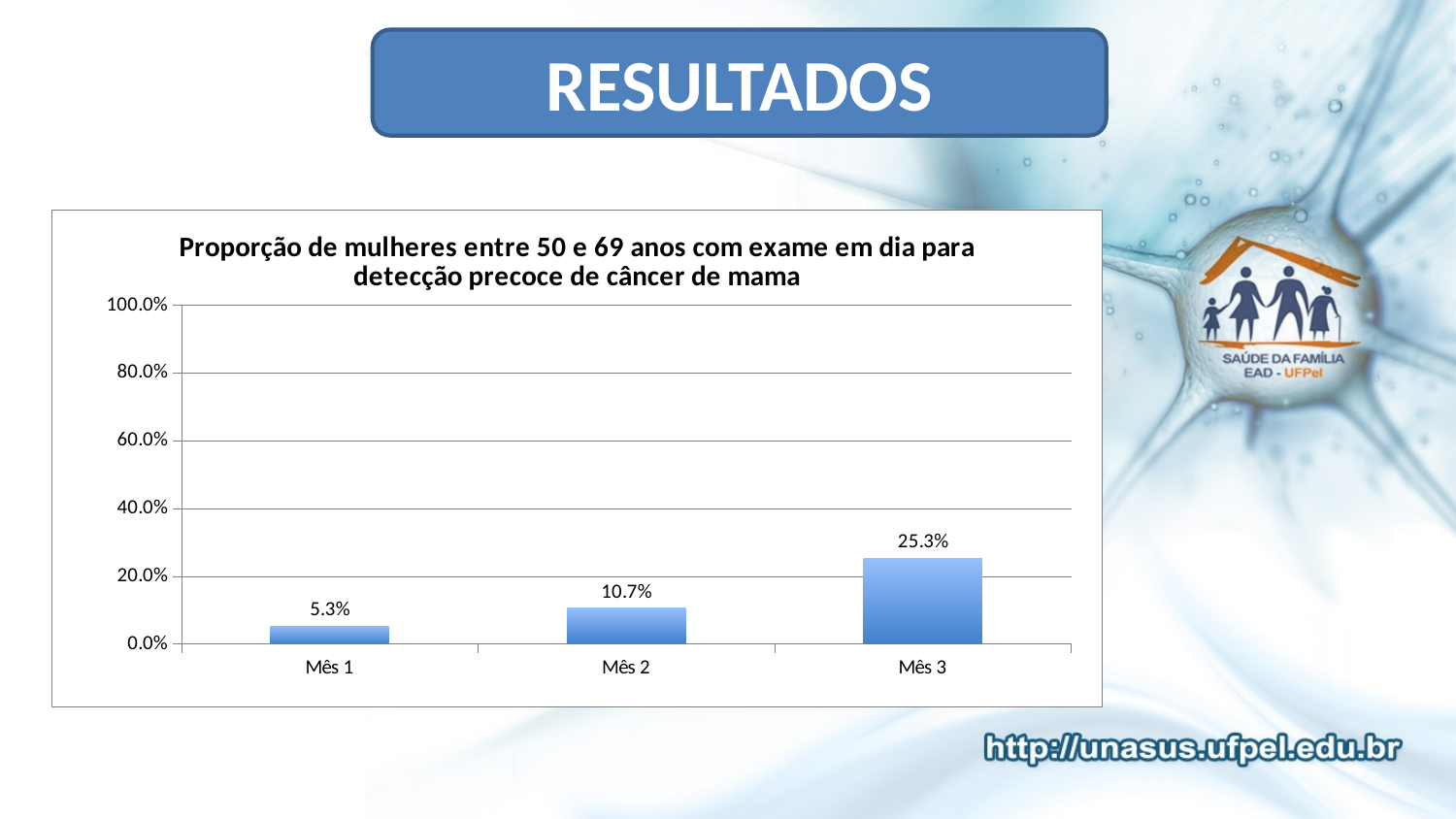
Do the values rise or fall from Mês 1 to Mês 3? Rise Which month has the lowest value? Mês 1 Is the value for Mês 3 greater or less than 20.0%? greater What is the value for Mês 3? 25.3% What is the value for Mês 1? 5.3% What is the difference between the values for Mês 3 and Mês 2? 14.6% Which is larger, the value for Mês 1 or the value for Mês 2? Mês 2 What is the value for Mês 2? 10.7% How many months are shown on the x axis? 3 Which month has the highest value? Mês 3 What kind of chart is shown on the slide? Bar chart What is the difference between the values for Mês 2 and Mês 1? 5.4%